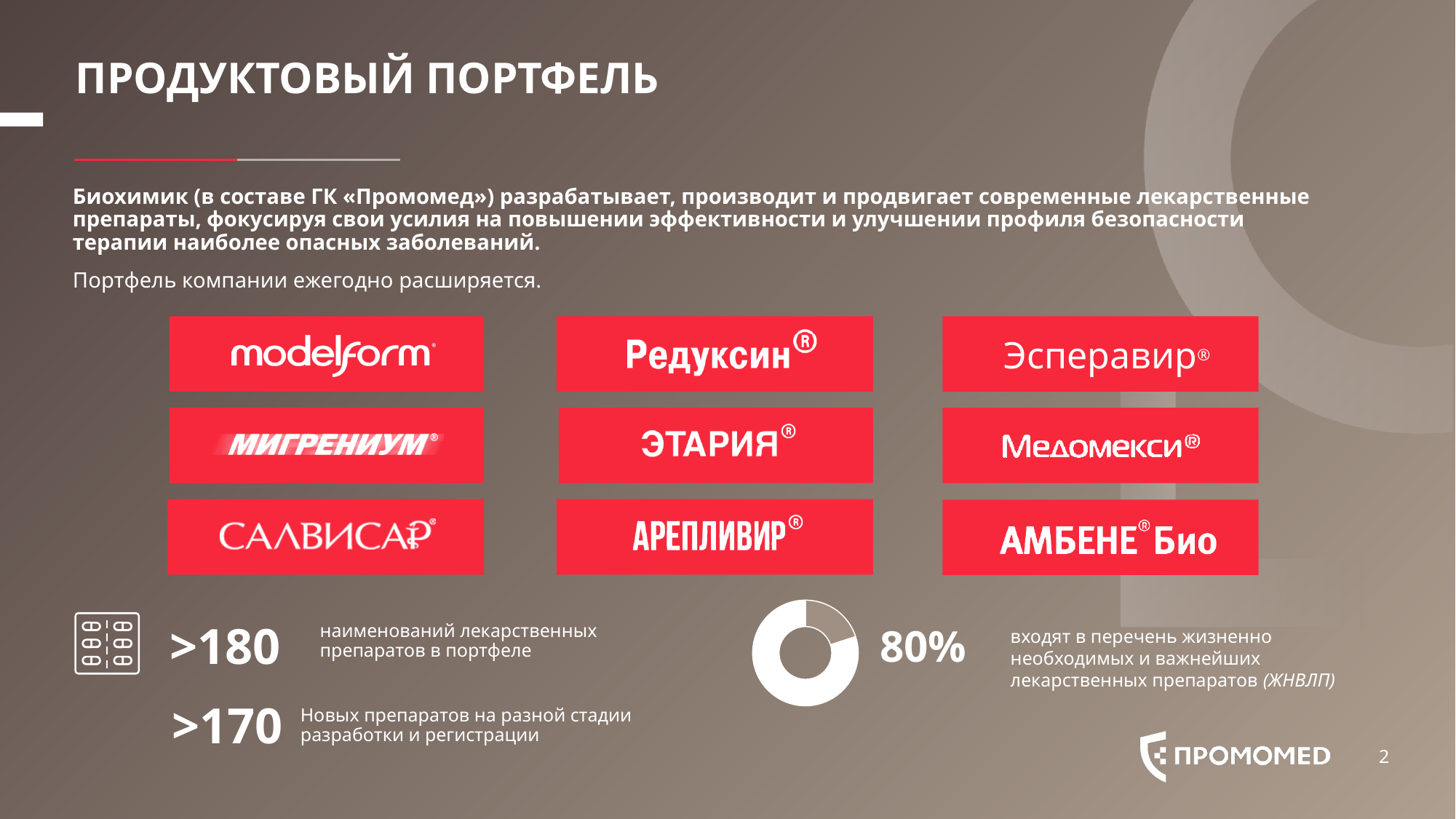
Is the highlighted share in the doughnut chart greater or less than 50%? greater What colour is the larger segment of the doughnut chart? White What percentage does the doughnut chart highlight? 80% According to the doughnut chart, what share of the drugs are included in the list of vital and essential medicines (ЖНВЛП)? 80% What kind of chart is shown at the bottom of the slide next to the 80% figure? Doughnut (pie) chart Which segment of the doughnut chart is larger: the white segment or the brown segment? The white segment What does the 80% in the doughnut chart refer to? Drugs included in the list of vital and essential medicines (ЖНВЛП) How many segments does the doughnut chart have? 2